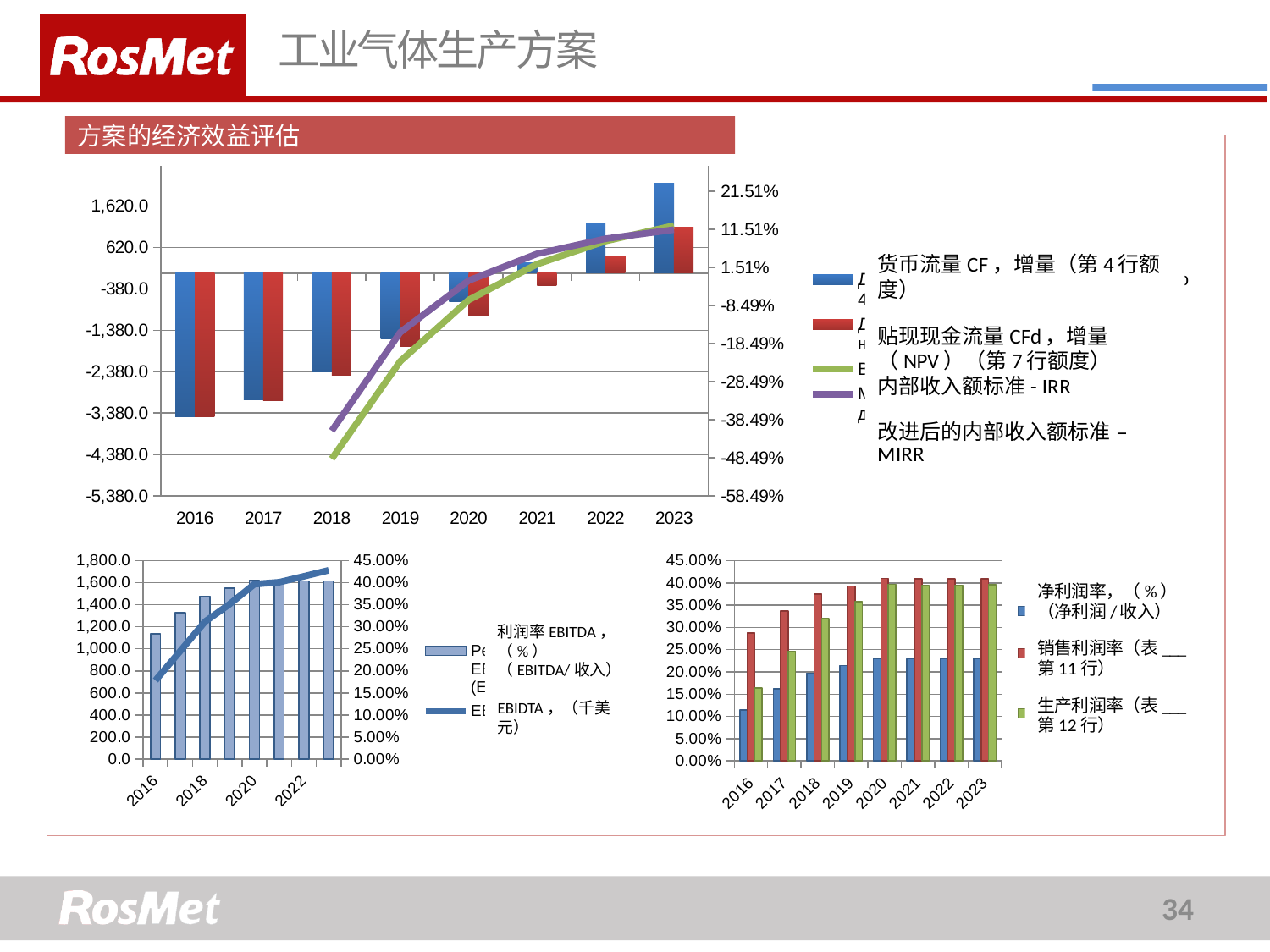
In the bottom-left chart, does the EBITDA series rise or fall from 2016 to 2023? rise What kind of chart is the top chart? Combination bar and line chart In the bottom-right chart, is the 净利润率 value for 2016 greater or less than 15.00%? less In the bottom-right chart, how many series does the legend list? 3 In the top chart, do the 货币流量 CF bars rise or fall from 2016 to 2023? rise In the bottom-left chart, how many bars are plotted? 8 In the top chart, is the 货币流量 CF bar for 2017 greater or less than -2,380.0? less In the bottom-right chart, which is larger for 2017: 生产利润率 or 净利润率? 生产利润率 In the top chart, how many series does the legend list? 4 In the top chart, is the 货币流量 CF bar for 2023 greater or less than 1,620.0? greater In the top chart, how many years are shown on the x axis? 8